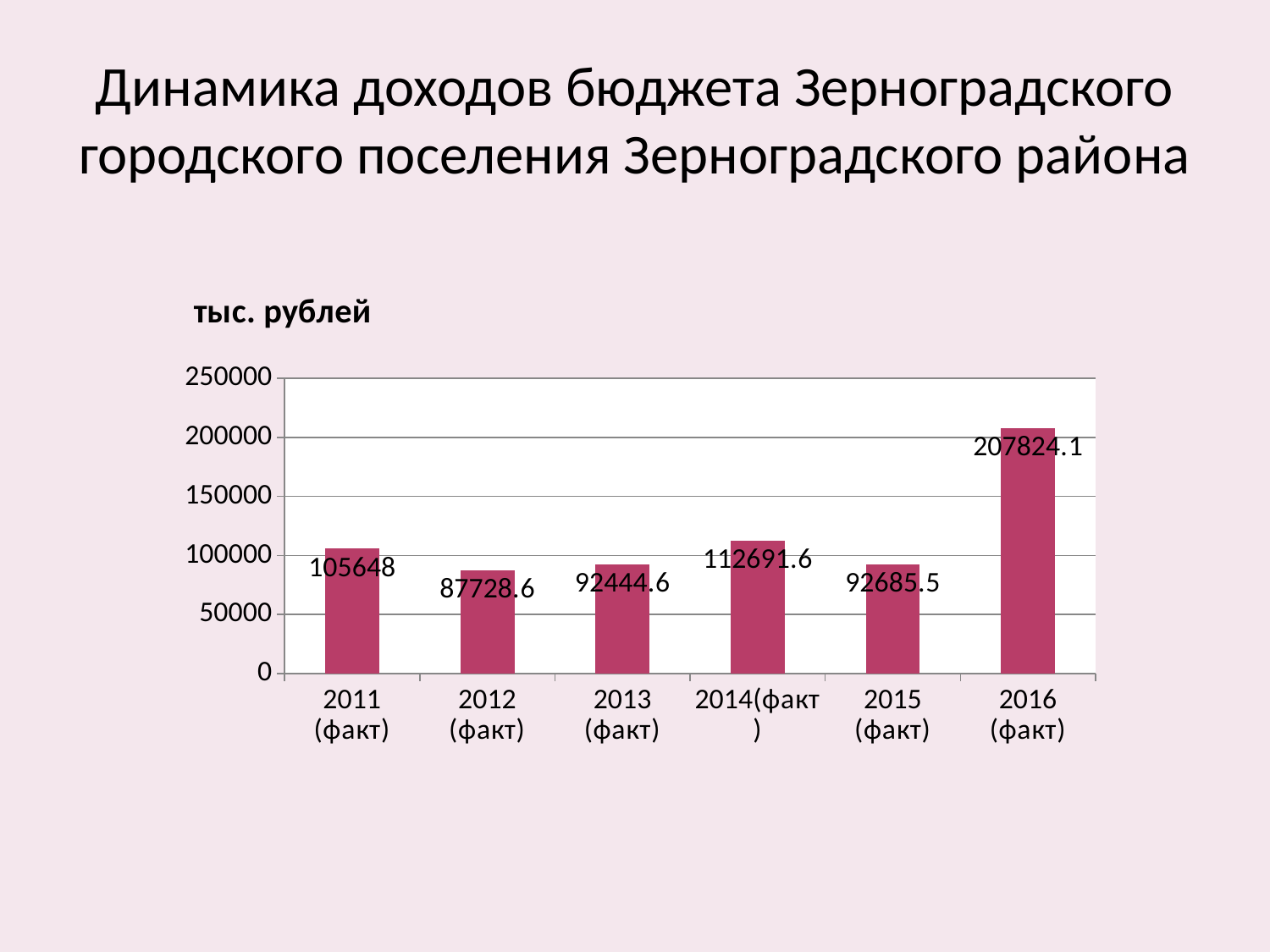
What is the value shown for 2016 (факт)? 207824.1 What unit is indicated above the chart's vertical axis? тыс. рублей Is the value for 2016 (факт) greater or less than 150000? greater Which year has the lowest budget revenue? 2012 (факт) How many years (categories) are shown on the chart? 6 Which is larger, the value for 2011 (факт) or the value for 2012 (факт)? 2011 (факт) What is the difference between the values for 2014(факт) and 2013 (факт)? 20247 Which year has the highest budget revenue? 2016 (факт) What is the budget revenue value for 2011 (факт)? 105648 What is the value shown for 2014(факт)? 112691.6 What is the difference between the values for 2016 (факт) and 2015 (факт)? 115138.6 What type of chart is shown on the slide? bar chart